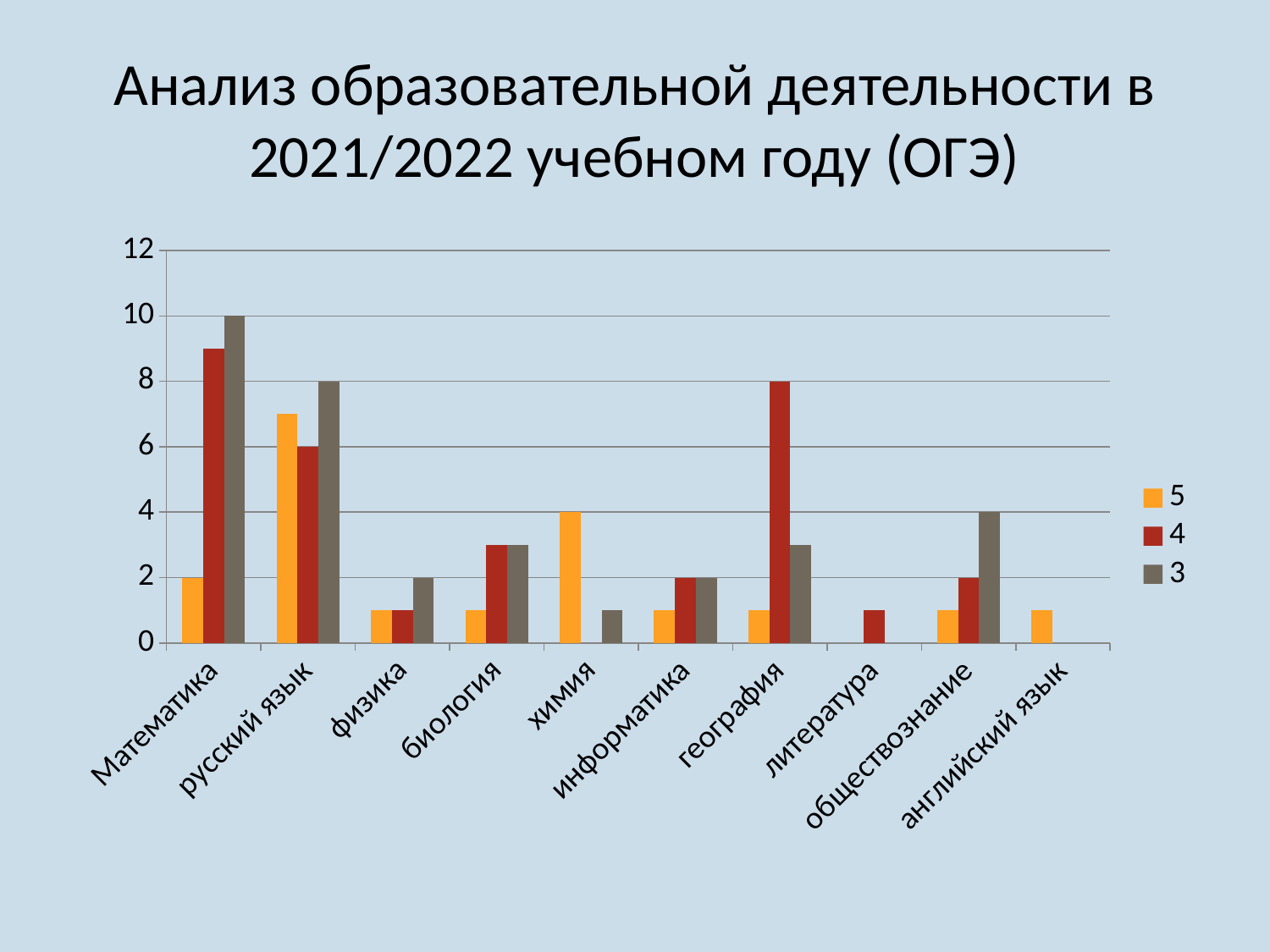
Is the value of series 4 for Математика greater or less than 8? greater How many subject categories are shown on the x axis? 10 What is the value of series 3 for русский язык? 8 How many series does the legend list? 3 Which subject has the highest value for series 3? Математика What is the value of series 5 for химия? 4 What is the difference between series 3 for Математика and series 3 for обществознание? 6 Which subject has the highest value for series 5? русский язык What is the value of series 4 for география? 8 What kind of chart is shown on the slide? bar chart Which is larger: series 4 for русский язык or series 4 for география? география What is the value of series 3 for Математика? 10